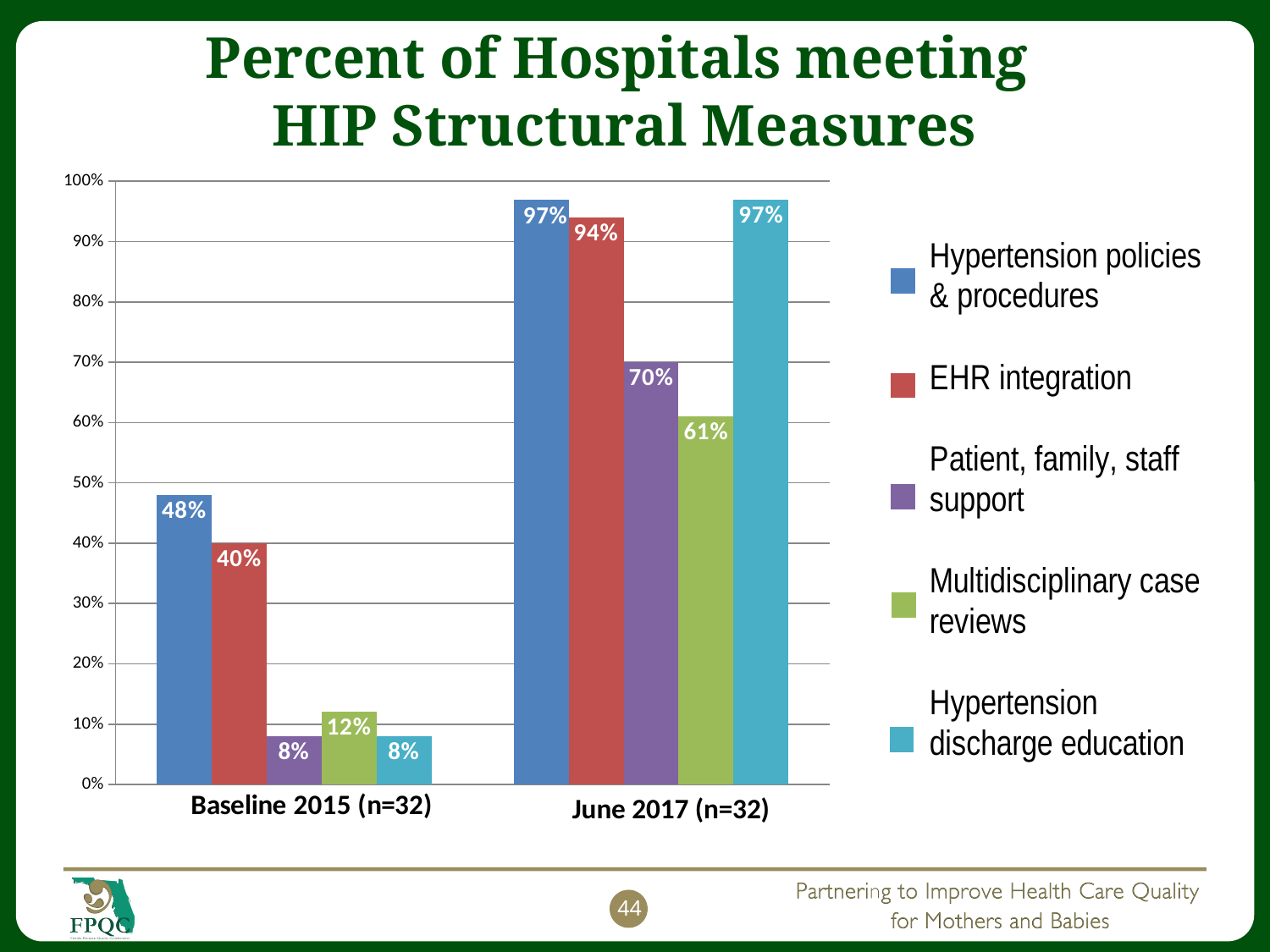
How many series does the legend list? 5 How many categories are shown on the x axis? 2 Which measure had the highest percent of hospitals at Baseline 2015 (n=32)? Hypertension policies & procedures What percent of hospitals met the Patient, family, staff support measure in June 2017 (n=32)? 70% Which measure had the lowest percent of hospitals in June 2017 (n=32)? Multidisciplinary case reviews What percent of hospitals met the Multidisciplinary case reviews measure at Baseline 2015 (n=32)? 12% Which colour represents EHR integration in the legend? Red Which is larger: the EHR integration value at Baseline 2015 (n=32) or the Patient, family, staff support value at Baseline 2015 (n=32)? EHR integration What is the difference in percentage points between the Hypertension discharge education values for June 2017 (n=32) and Baseline 2015 (n=32)? 89 What percent of hospitals met the EHR integration measure in June 2017 (n=32)? 94% What kind of chart is shown on the slide? Bar chart What percent of hospitals met the Hypertension policies & procedures measure at Baseline 2015 (n=32)? 48%